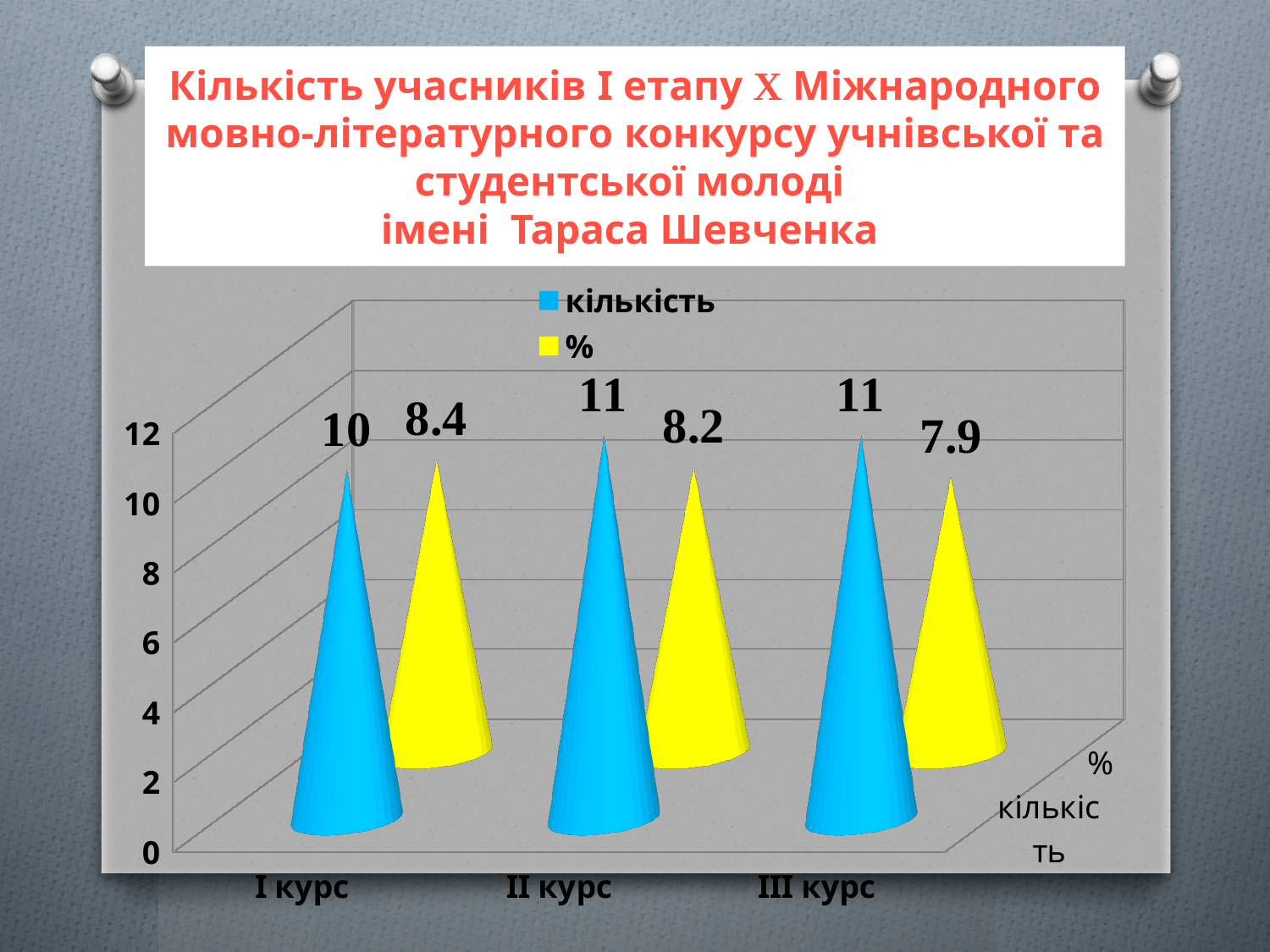
What is the difference between the % values for I курс and III курс? 0.5 Which category has the lowest value in the кількість series? I курс What is the value of % for III курс? 7.9 What is the value of % for II курс? 8.2 Do the % values rise or fall from I курс to III курс? fall What kind of chart is shown on the slide? bar chart Which category has the highest value in the % series? I курс Which is larger: the кількість value for II курс or for I курс? II курс How many categories are shown on the x axis? 3 What is the value of кількість for III курс? 11 What is the value of кількість for I курс? 10 How many series does the legend list? 2